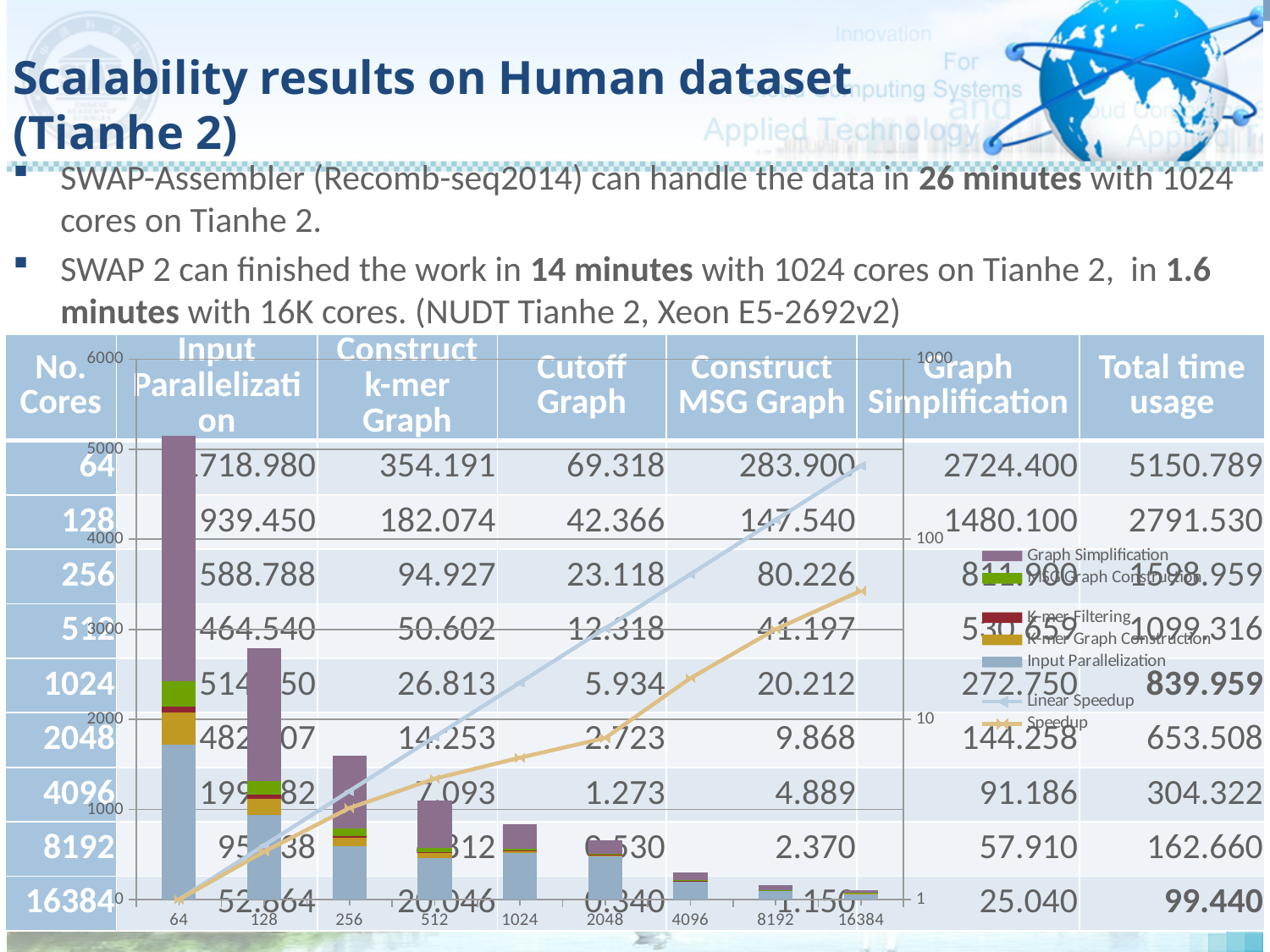
How many core-count categories are shown on the x axis of the chart? 9 Do the stacked bar heights rise or fall as the number of cores increases along the x axis? fall What is the maximum value shown on the left vertical axis of the chart? 6000 How many series does the chart's legend list? 7 Is the total stacked bar for 128 cores greater or less than 3000? less Which core count has the tallest stacked bar in the chart? 64 Which core count has the shortest stacked bar in the chart? 16384 What kind of chart is shown on the slide? stacked bar chart (with speedup lines) Which stacked bar is taller, the one for 128 cores or the one for 256 cores? 128 cores Does the Speedup line rise or fall as the number of cores increases along the x axis? rise Is the total stacked bar for 64 cores greater or less than 4000? greater Is the total stacked bar for 1024 cores greater or less than 1000? less